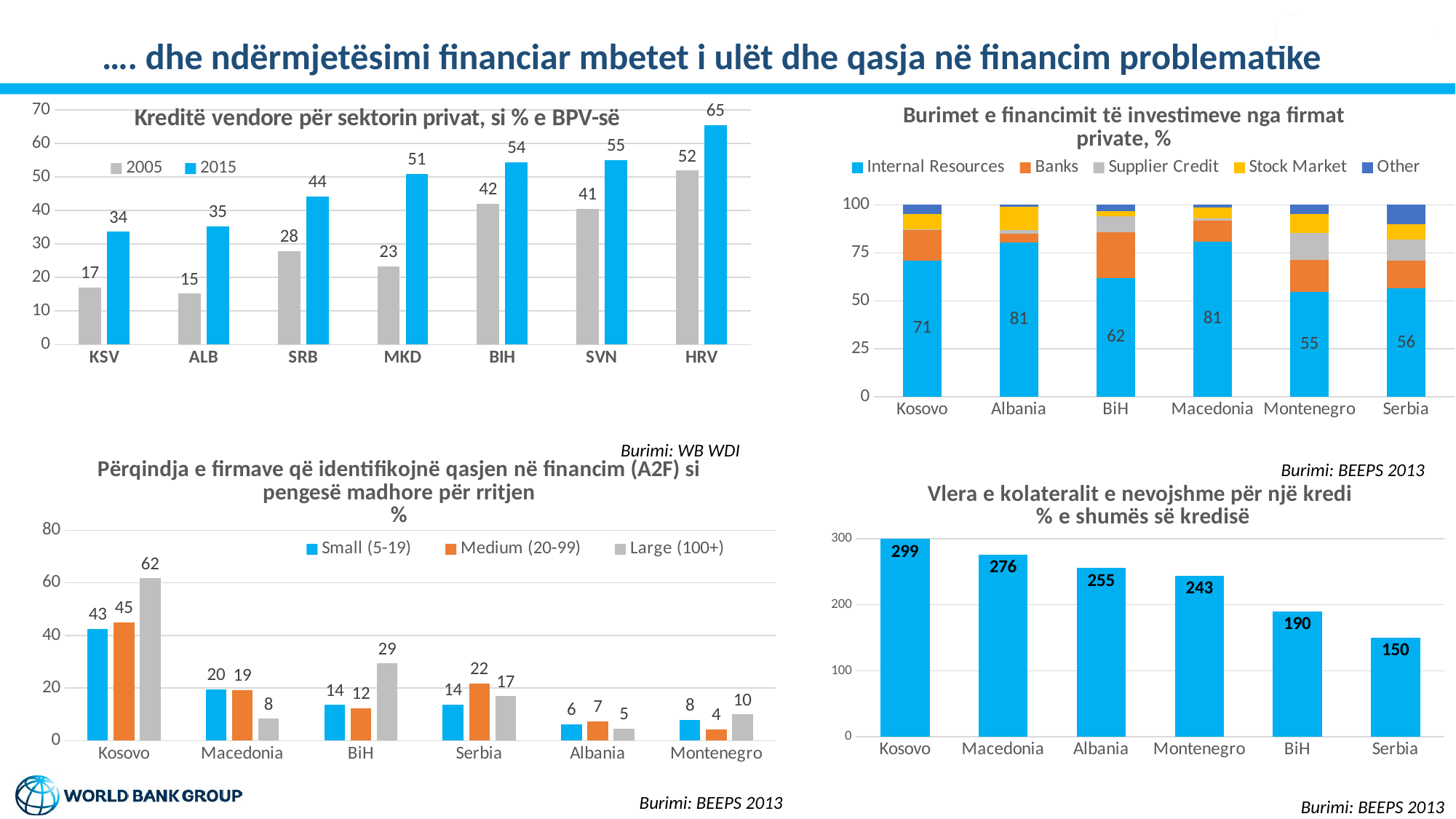
In the chart 'Burimet e financimit të investimeve nga firmat private, %', which country has the lowest Internal Resources value? Montenegro In the chart 'Përqindja e firmave që identifikojnë qasjen në financim (A2F) si pengesë madhore për rritjen %', what is the Large (100+) value for BiH? 29 In the chart 'Kreditë vendore për sektorin privat, si % e BPV-së', what is the difference between the 2015 and 2005 values for SRB? 16 In the chart 'Kreditë vendore për sektorin privat, si % e BPV-së', what is the 2015 value for MKD? 51 In the chart 'Vlera e kolateralit e nevojshme për një kredi % e shumës së kredisë', what is the value for Albania? 255 What kind of chart is 'Vlera e kolateralit e nevojshme për një kredi % e shumës së kredisë'? bar chart In the chart 'Burimet e financimit të investimeve nga firmat private, %', what is the Internal Resources value for Montenegro? 55 In the chart 'Kreditë vendore për sektorin privat, si % e BPV-së', how many countries are shown on the x axis? 7 In the chart 'Përqindja e firmave që identifikojnë qasjen në financim (A2F) si pengesë madhore për rritjen %', which is larger for Serbia: Small (5-19) or Medium (20-99)? Medium (20-99) In the chart 'Vlera e kolateralit e nevojshme për një kredi % e shumës së kredisë', do the values rise or fall from left to right along the x axis? fall In the chart 'Burimet e financimit të investimeve nga firmat private, %', how many series does the legend list? 5 In the chart 'Kreditë vendore për sektorin privat, si % e BPV-së', which country has the highest 2015 value? HRV